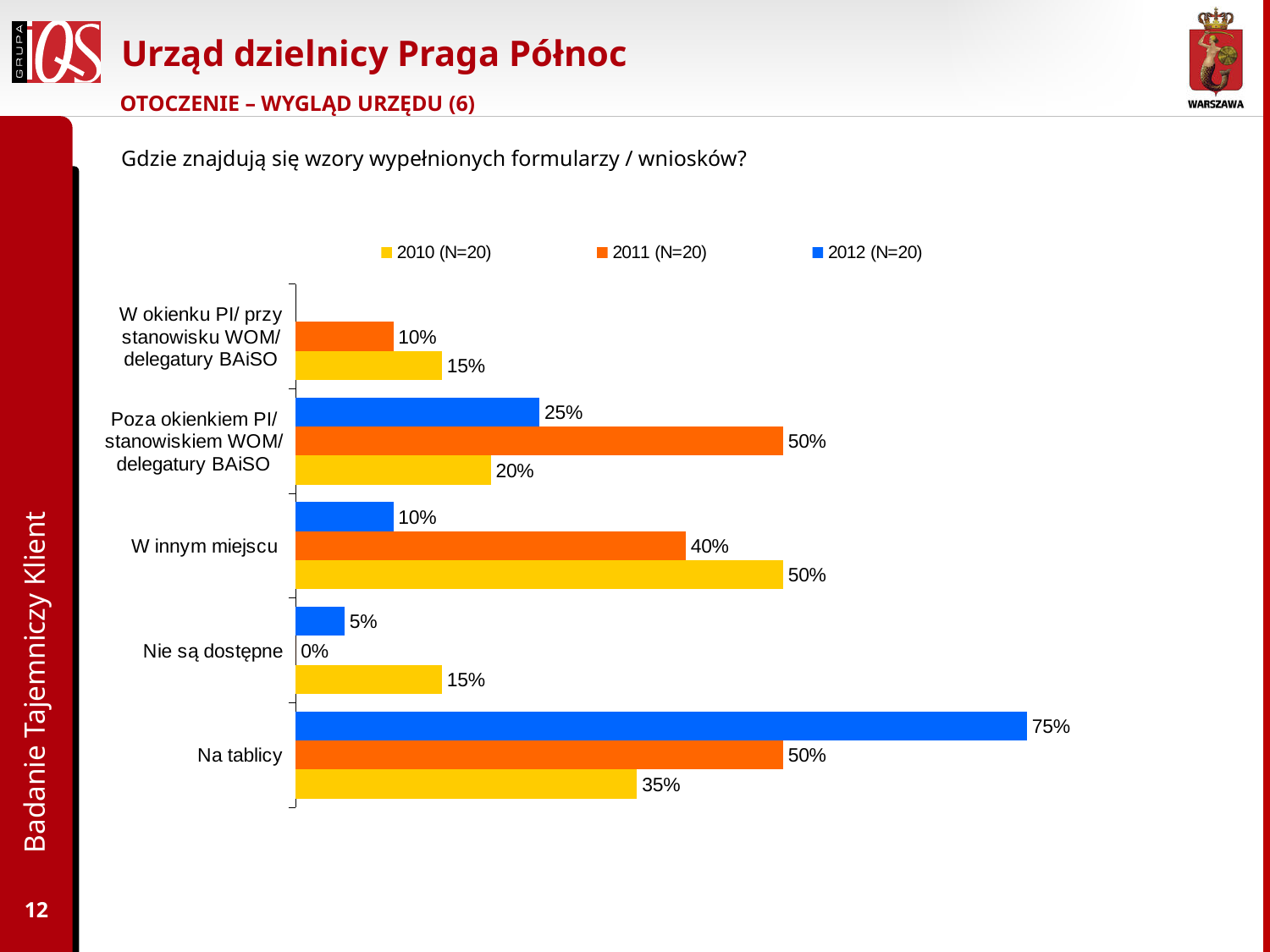
What is the value for 'W innym miejscu' in the 2011 (N=20) series? 40% What kind of chart is shown on the slide? bar chart How many series does the legend list? 3 What is the value for 'Poza okienkiem PI/ stanowiskiem WOM/ delegatury BAiSO' in the 2012 (N=20) series? 25% Which category has the lowest value in the 2011 (N=20) series? Nie są dostępne What is the value for 'Na tablicy' in the 2012 (N=20) series? 75% What is the value for 'Nie są dostępne' in the 2010 (N=20) series? 15% What is the difference between the 2012 (N=20) and 2010 (N=20) values for 'Na tablicy'? 40% For 'W innym miejscu', which is larger: the 2010 (N=20) value or the 2012 (N=20) value? 2010 (N=20) Which category has the highest value in the 2012 (N=20) series? Na tablicy Which colour represents the 2011 (N=20) series in the legend? orange How many categories are shown on the chart? 5